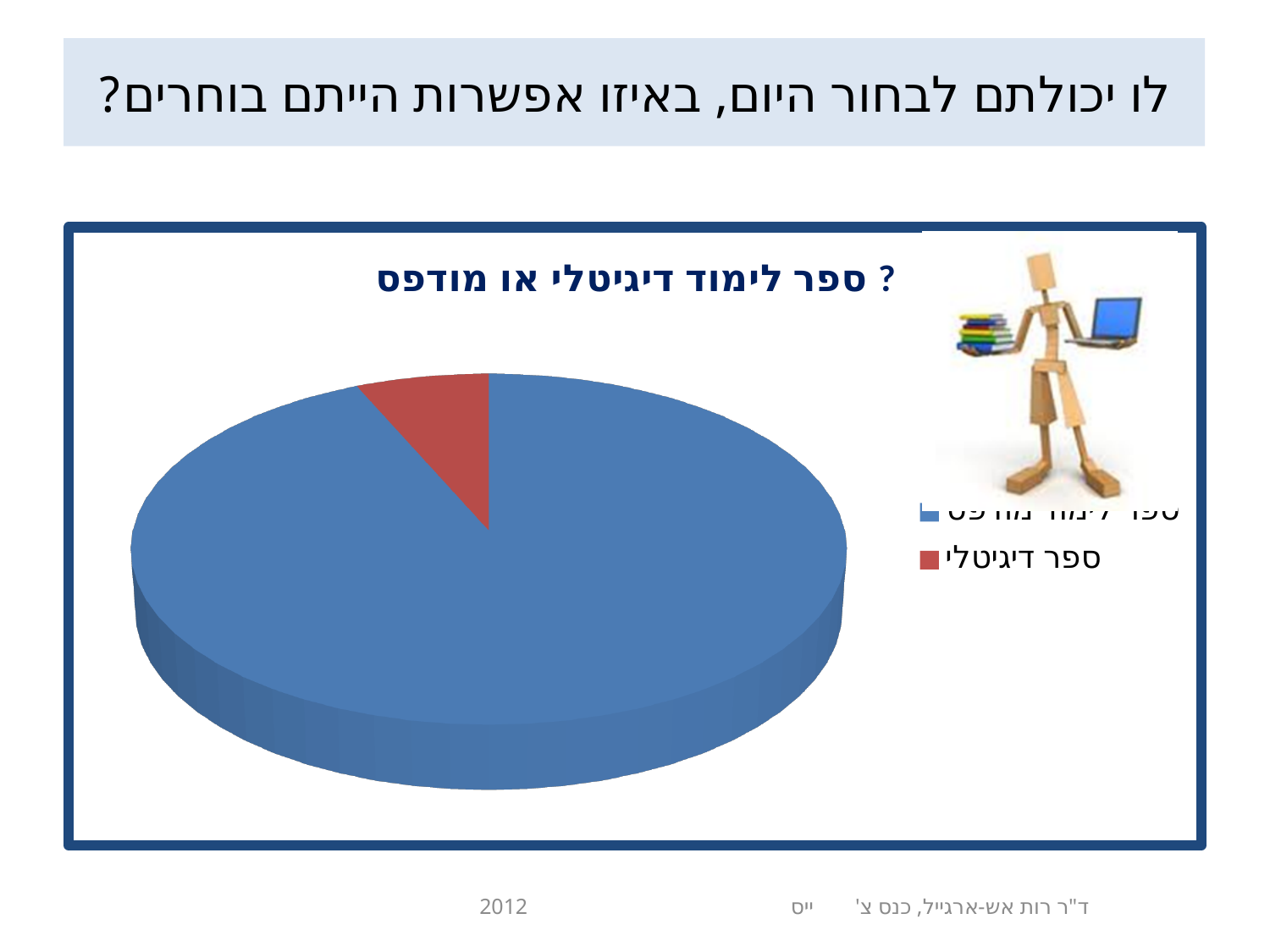
Which category has the smallest slice of the pie? ספר דיגיטלי What colour is the slice for ספר דיגיטלי? red Which slice is larger: the blue slice or the red slice (ספר דיגיטלי)? the blue slice Does the slice for ספר דיגיטלי take up more or less than half of the pie? less How many entries does the chart legend list? 2 What kind of chart is shown on the slide? pie chart How many slices does the pie chart have? 2 What is the title of the chart? ספר לימוד דיגיטלי או מודפס ?